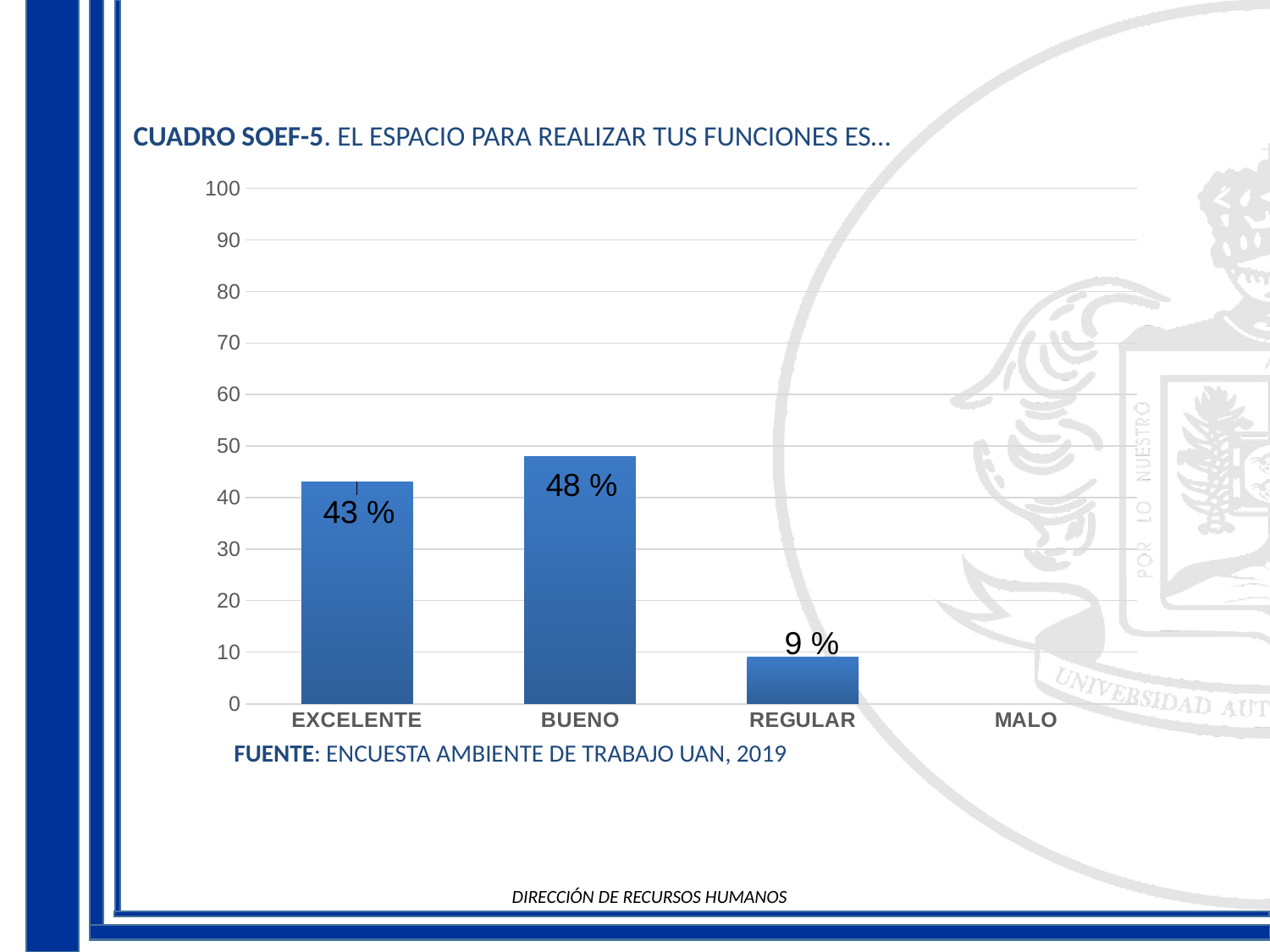
Is the value for REGULAR greater or less than 20? less Which is larger, the value for EXCELENTE or the value for REGULAR? EXCELENTE Is the value for BUENO greater or less than 40? greater What is the difference between the values for BUENO and EXCELENTE? 5 % What is the difference between the values for BUENO and REGULAR? 39 % What is the value shown for BUENO? 48 % What source is cited below the chart? ENCUESTA AMBIENTE DE TRABAJO UAN, 2019 How many categories are shown on the x axis? 4 What kind of chart is shown on the slide? bar chart What is the value shown for REGULAR? 9 % What is the value shown for EXCELENTE? 43 % Which category has the highest value? BUENO